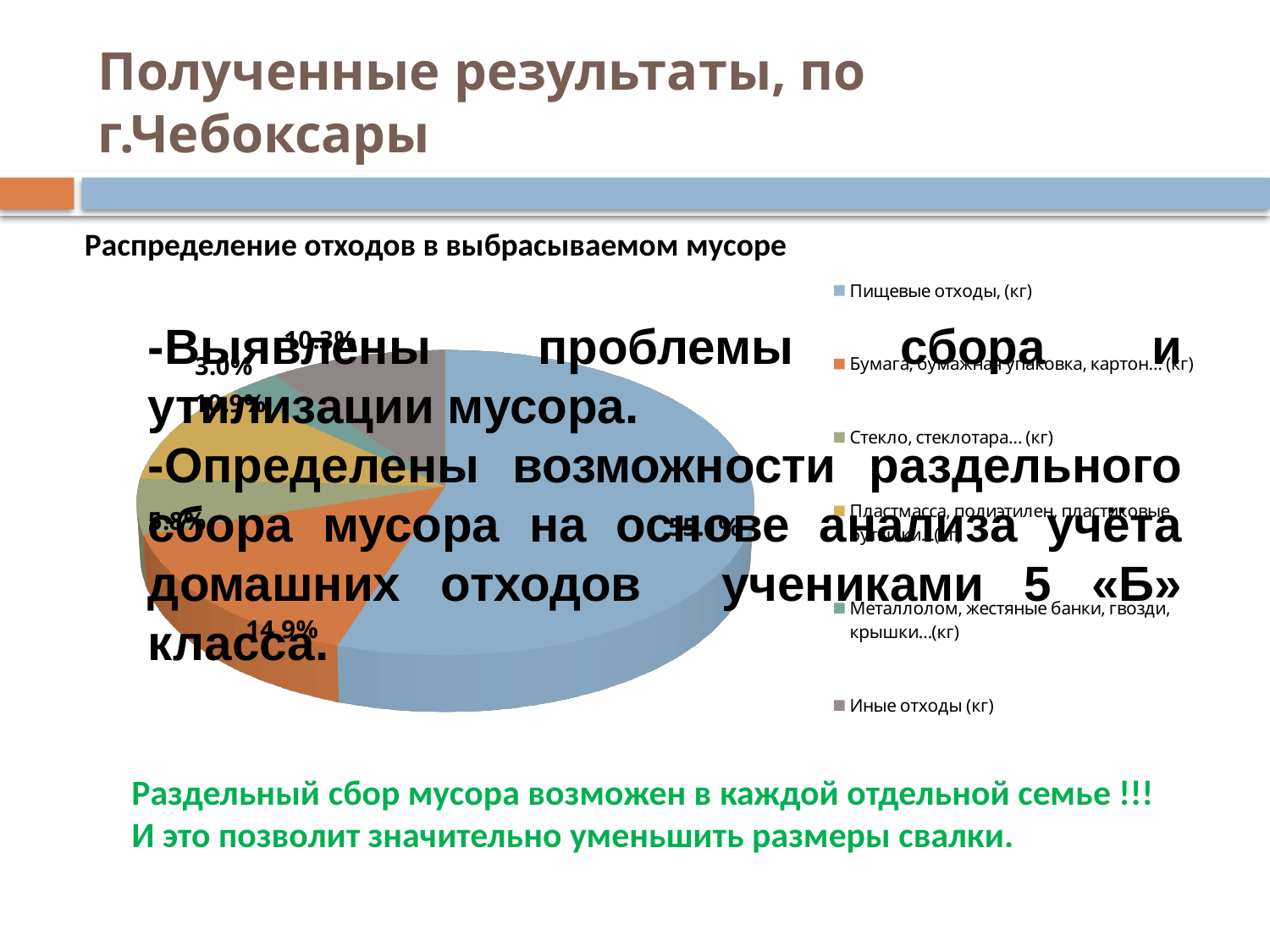
What share of the pie is labelled for Бумага, бумажная упаковка, картон... (кг)? 14.9% What share of the pie is labelled for Иные отходы (кг)? 10.3% What share of the pie is labelled for Металлолом, жестяные банки, гвозди, крышки...(кг)? 3.0% What kind of chart is shown on the slide? pie chart What share of the pie is labelled for Пластмасса, полиэтилен, пластиковые бутылки...(кг)? 10.9% What is the difference between the shares for Бумага, бумажная упаковка, картон... (кг) and Иные отходы (кг)? 4.6% Which category has the smallest slice of the pie? Металлолом, жестяные банки, гвозди, крышки...(кг) What is the title of the chart? Распределение отходов в выбрасываемом мусоре Is the share for Пищевые отходы, (кг) greater or less than 50%? greater How many categories does the chart's legend list? 6 Which category has the largest slice of the pie? Пищевые отходы, (кг) Which is larger: the share for Бумага, бумажная упаковка, картон... (кг) or the share for Иные отходы (кг)? Бумага, бумажная упаковка, картон... (кг)